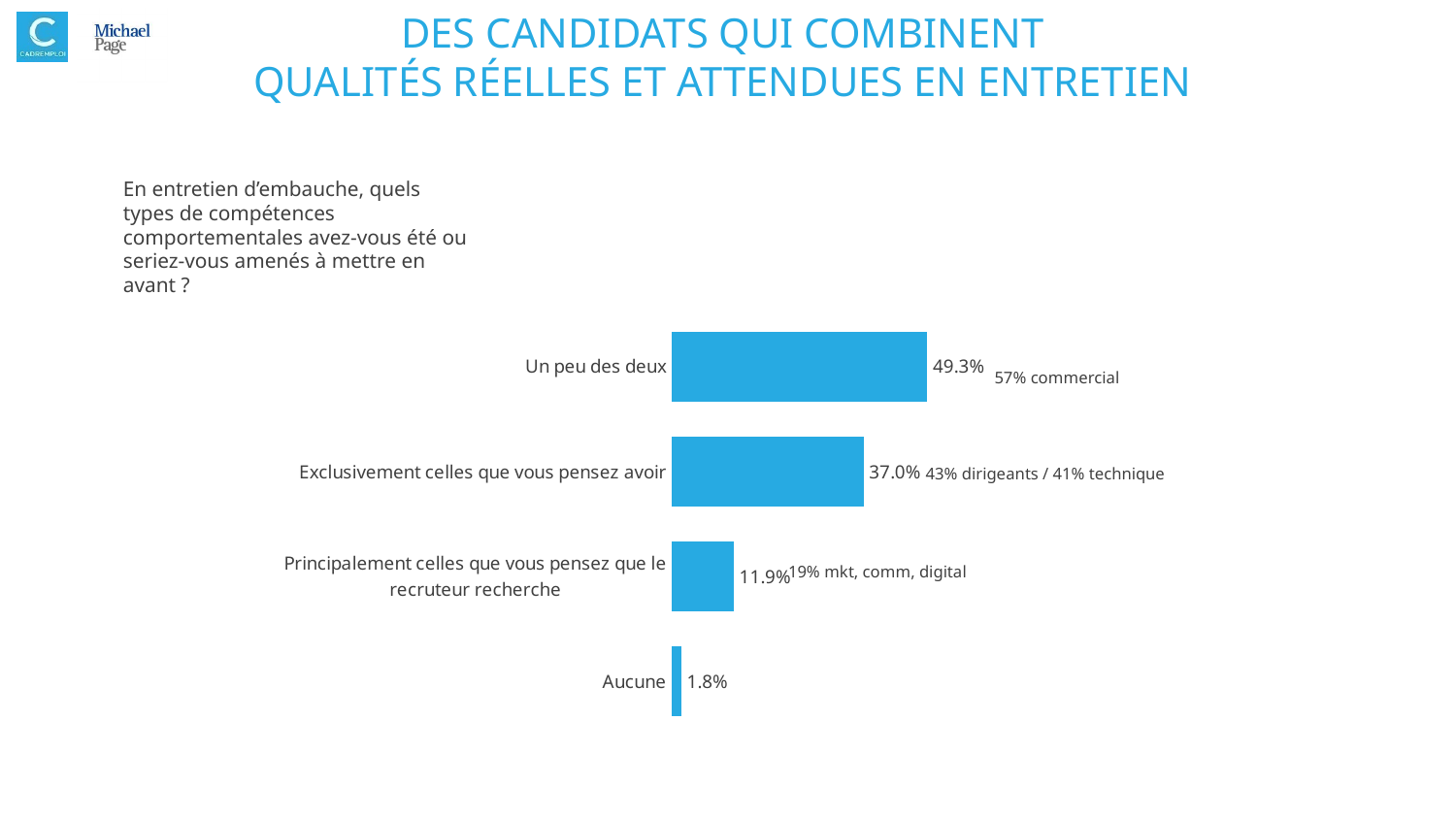
What is the value for "Un peu des deux"? 49.3% What is the difference between the values for "Principalement celles que vous pensez que le recruteur recherche" and "Aucune"? 10.1% What is the value for "Exclusivement celles que vous pensez avoir"? 37.0% What is the value for "Aucune"? 1.8% What annotation is written next to the bar for "Un peu des deux"? 57% commercial What kind of chart is shown on the slide? Bar chart Which category has the highest value? Un peu des deux How many categories are shown in the chart? 4 Which category has the lowest value? Aucune What is the difference between the values for "Un peu des deux" and "Exclusivement celles que vous pensez avoir"? 12.3% What is the value for "Principalement celles que vous pensez que le recruteur recherche"? 11.9% Which is larger, the value for "Exclusivement celles que vous pensez avoir" or the value for "Principalement celles que vous pensez que le recruteur recherche"? Exclusivement celles que vous pensez avoir